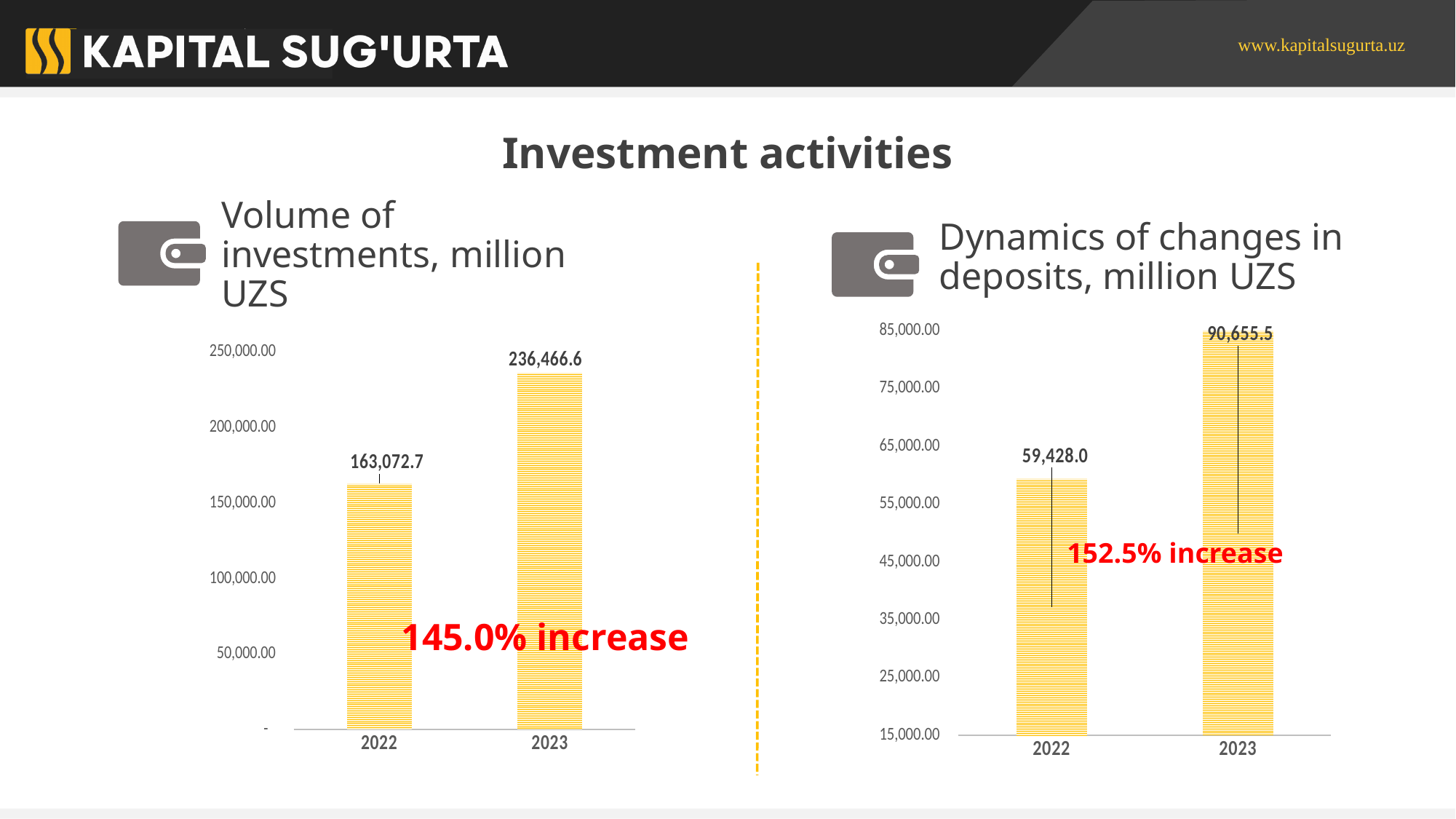
In the 'Volume of investments, million UZS' chart, which year has the higher value? 2023 In the 'Dynamics of changes in deposits, million UZS' chart, is the value for 2022 greater or less than 55,000.00? greater In the 'Dynamics of changes in deposits, million UZS' chart, what is the difference between the 2023 and 2022 values? 31,227.5 How many bars are shown in the 'Volume of investments, million UZS' chart? 2 What type of chart is the 'Dynamics of changes in deposits, million UZS' chart? Bar chart In the 'Dynamics of changes in deposits, million UZS' chart, what is the value for 2022? 59,428.0 In the 'Dynamics of changes in deposits, million UZS' chart, what is the value for 2023? 90,655.5 In the 'Volume of investments, million UZS' chart, what is the value for 2022? 163,072.7 In the 'Volume of investments, million UZS' chart, what is the difference between the 2023 and 2022 values? 73,393.9 In the 'Dynamics of changes in deposits, million UZS' chart, which year has the lowest value? 2022 What percentage increase is annotated on the 'Volume of investments, million UZS' chart? 145.0% increase In the 'Volume of investments, million UZS' chart, what is the value for 2023? 236,466.6